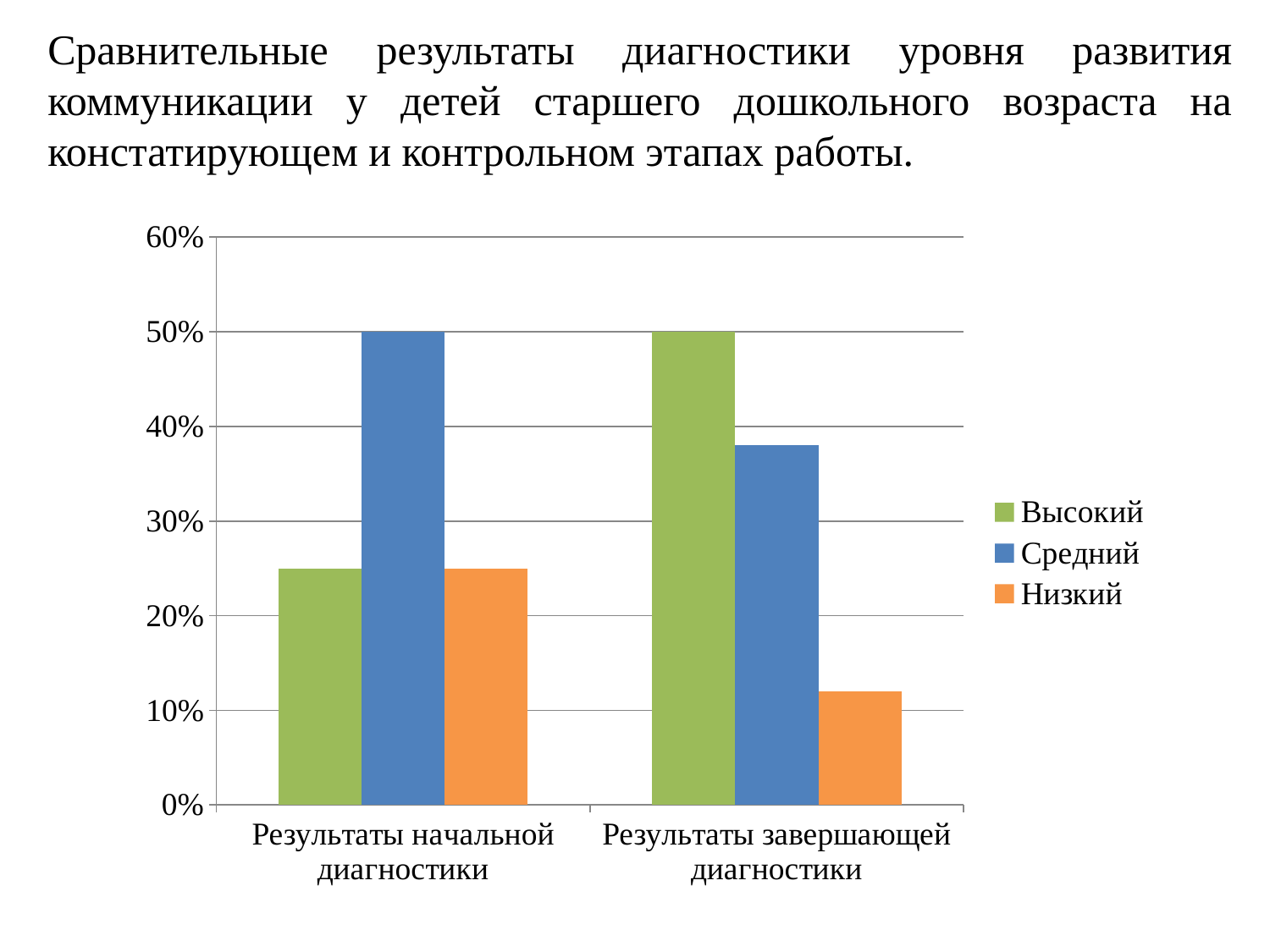
Which colour represents the Низкий series in the legend? orange Which series has the lowest value in Результаты завершающей диагностики? Низкий What is the value for Высокий in Результаты завершающей диагностики? 50% Which series has the highest value in Результаты начальной диагностики? Средний Is the value for Средний in Результаты завершающей диагностики greater or less than 40%? less What kind of chart is shown on the slide? bar chart Which is larger: Высокий in Результаты начальной диагностики or Высокий in Результаты завершающей диагностики? Результаты завершающей диагностики How many categories are shown on the x axis? 2 How many series does the legend list? 3 Is the value for Высокий in Результаты начальной диагностики greater or less than 30%? less Is the value for Низкий in Результаты завершающей диагностики greater or less than 10%? greater What is the value for Средний in Результаты начальной диагностики? 50%